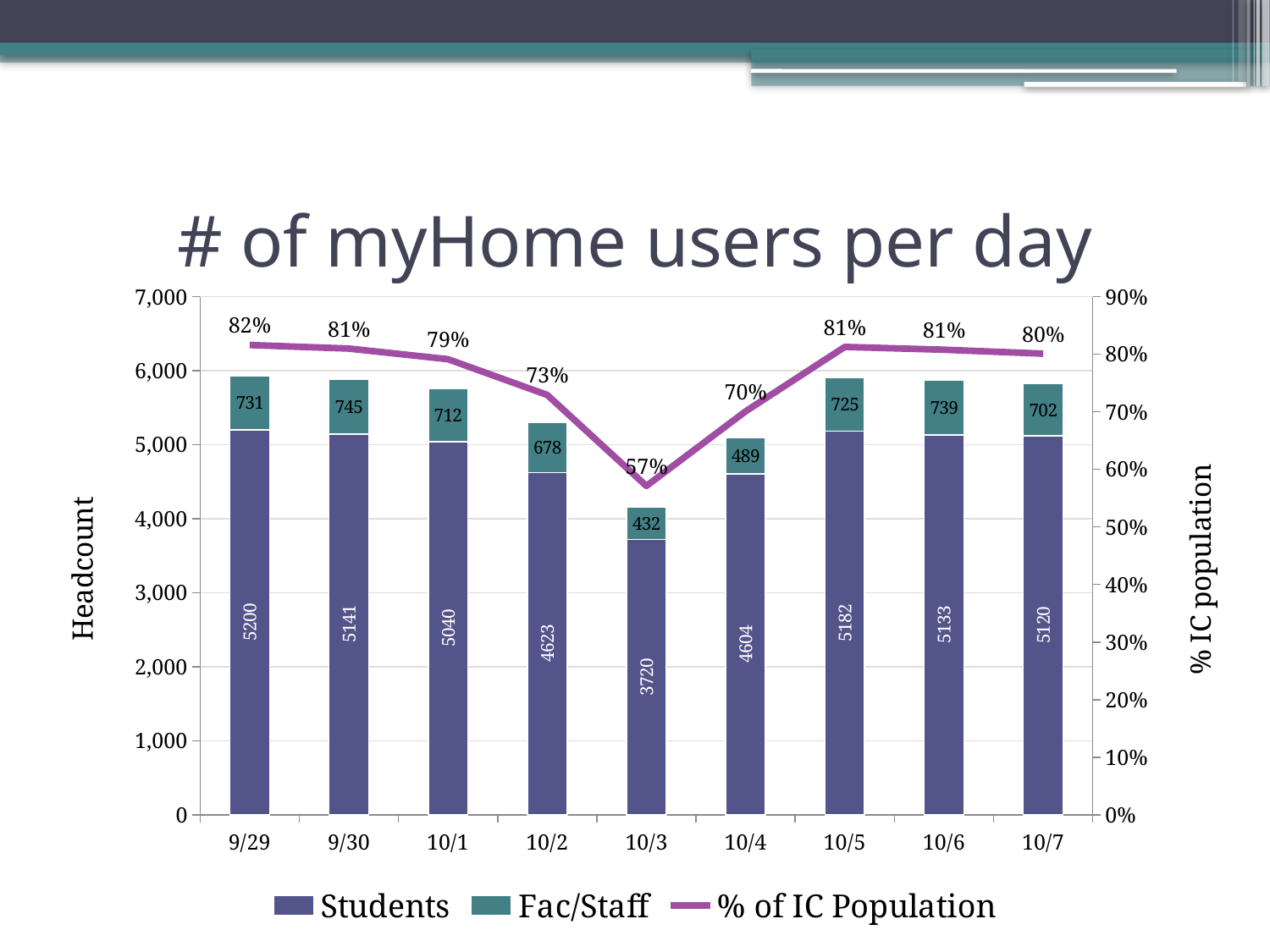
What is the title of the chart? # of myHome users per day Which day has the lowest Students value? 10/3 What is the difference between the Students values for 9/29 and 10/3? 1480 How many days are shown on the x axis? 9 What is the Students value for 10/3? 3720 What is the % of IC Population value for 10/2? 73% What is the Fac/Staff value for 9/30? 745 What is the total headcount (Students plus Fac/Staff) for 9/29? 5931 Which day has the highest Students value? 9/29 How many series does the legend list? 3 Which is larger, the Fac/Staff value for 10/4 or for 10/5? 10/5 Which day has the lowest % of IC Population? 10/3